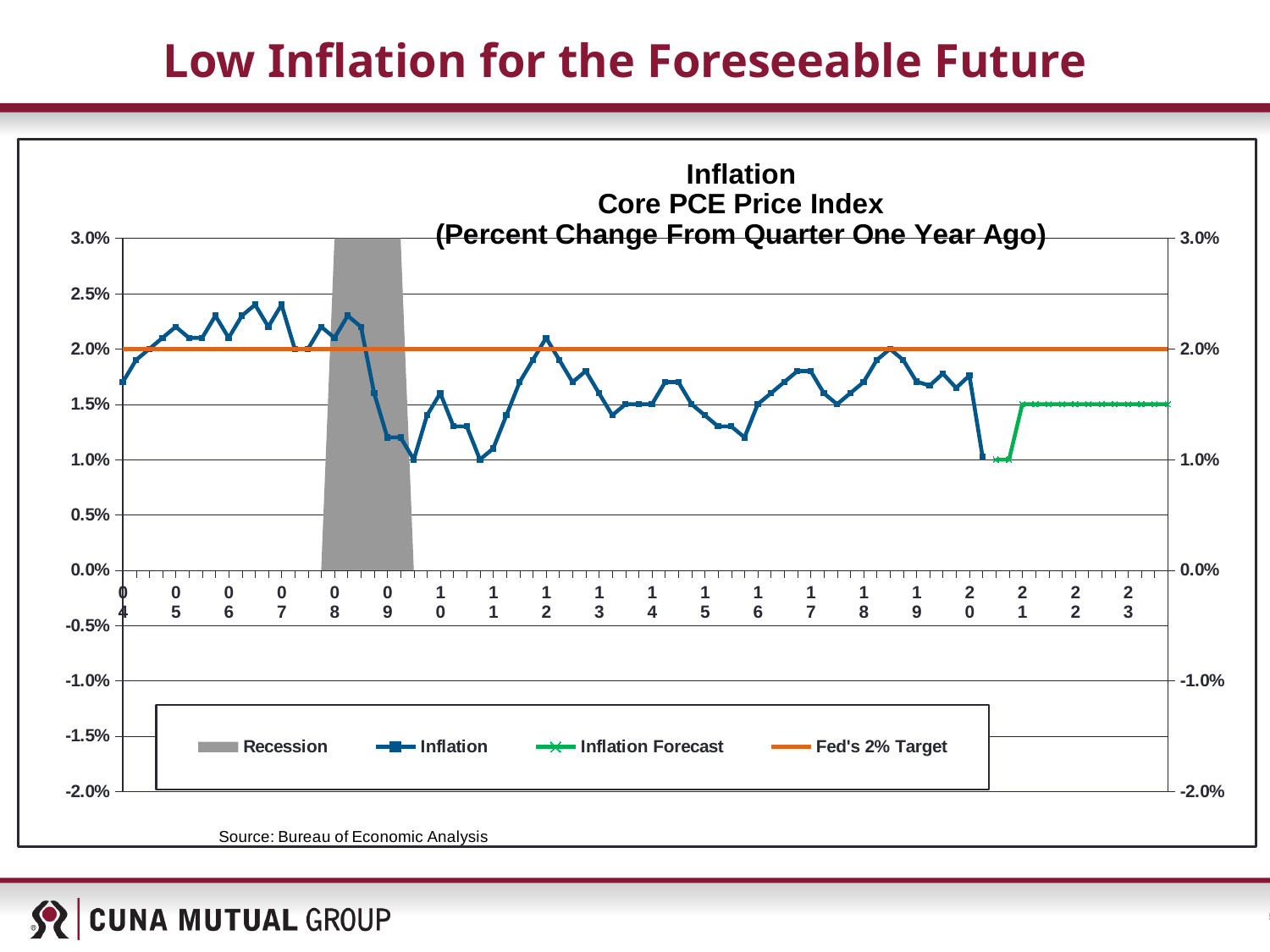
How many year labels are shown along the x axis? 20 Is the Inflation value in 2006 greater or less than 2.0%? greater Is the Inflation value at the end of 2020 greater or less than 1.5%? less Does the Inflation line generally rise or fall from 2004 to 2007? rise At what value does the Fed's 2% Target line sit on the chart? 2.0% At what level does the Inflation Forecast line flatten out from 2021 onward? 1.5% Is the Inflation value in 2009 greater or less than 1.5%? less What colour is the Fed's 2% Target line? orange Does the Inflation line rise or fall between 2008 and 2009? fall How many series does the chart legend list? 4 What kind of chart is shown on the slide? line chart What is the source cited for the chart data? Bureau of Economic Analysis